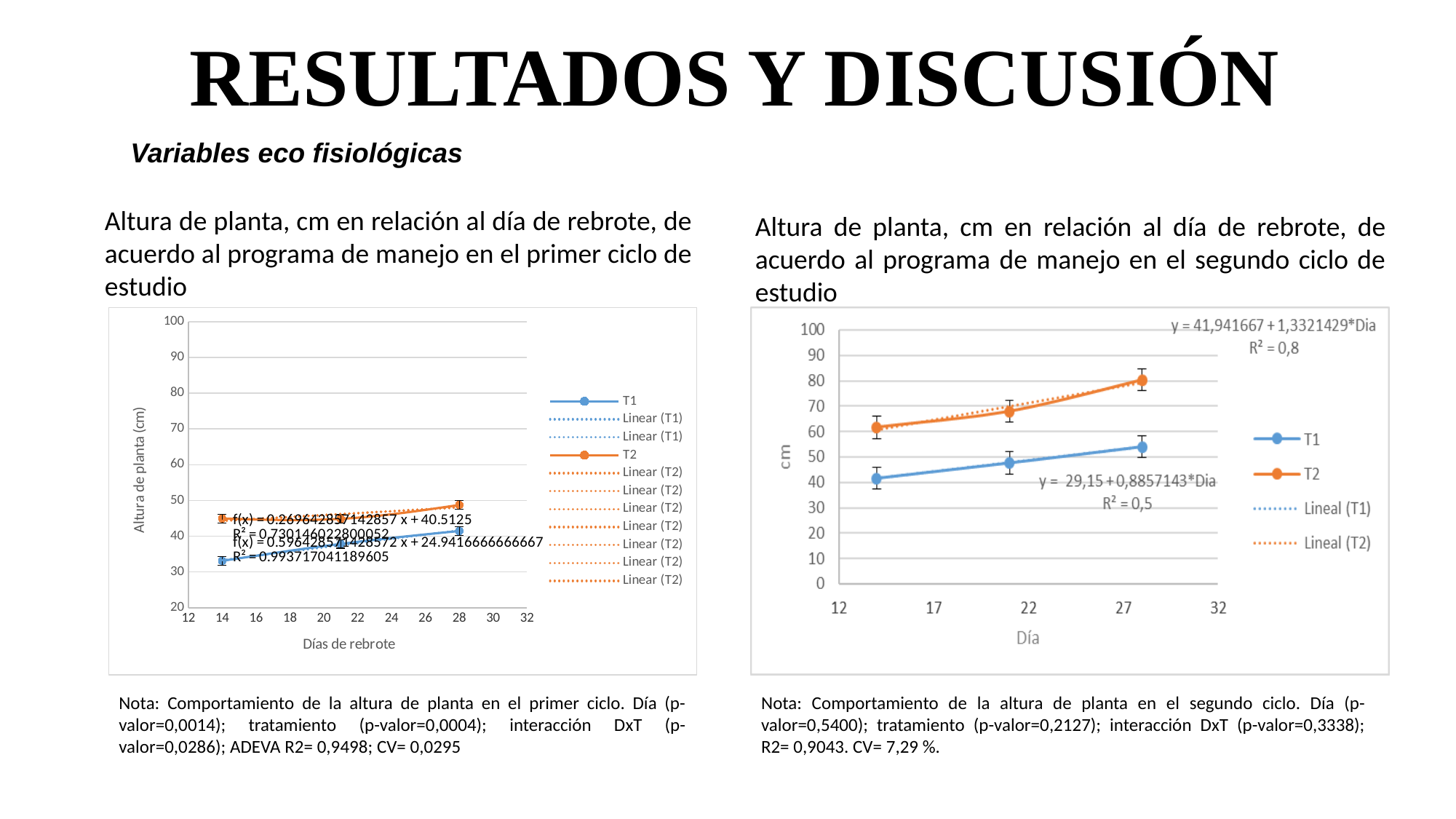
In the chart on the left (first cycle), how many data points are plotted for the T1 series? 3 In the chart on the right (second cycle), is the value of T2 at the last plotted day greater or less than 70? greater In the chart on the right (second cycle), is the value of T1 at the first plotted day greater or less than 50? less In the chart on the left (first cycle), does the T1 series rise or fall along the x axis? Rises In the chart on the right (second cycle), how many entries does the legend list? 4 In the chart on the right (second cycle), which series has the higher value at the last plotted day, T1 or T2? T2 In the chart on the right (second cycle), does the T2 series rise or fall as the day increases? Rises In the chart on the left (first cycle), is the value of T1 at day 14 greater or less than 40? less In the chart on the left (first cycle), which series has the lower value at day 14, T1 or T2? T1 In the chart on the right (second cycle), what R² value is printed for the T2 trend line equation? R² = 0,8 What is the x-axis title of the chart on the left (first cycle)? Días de rebrote What kind of chart is the one on the left, for the first cycle of study? Line chart